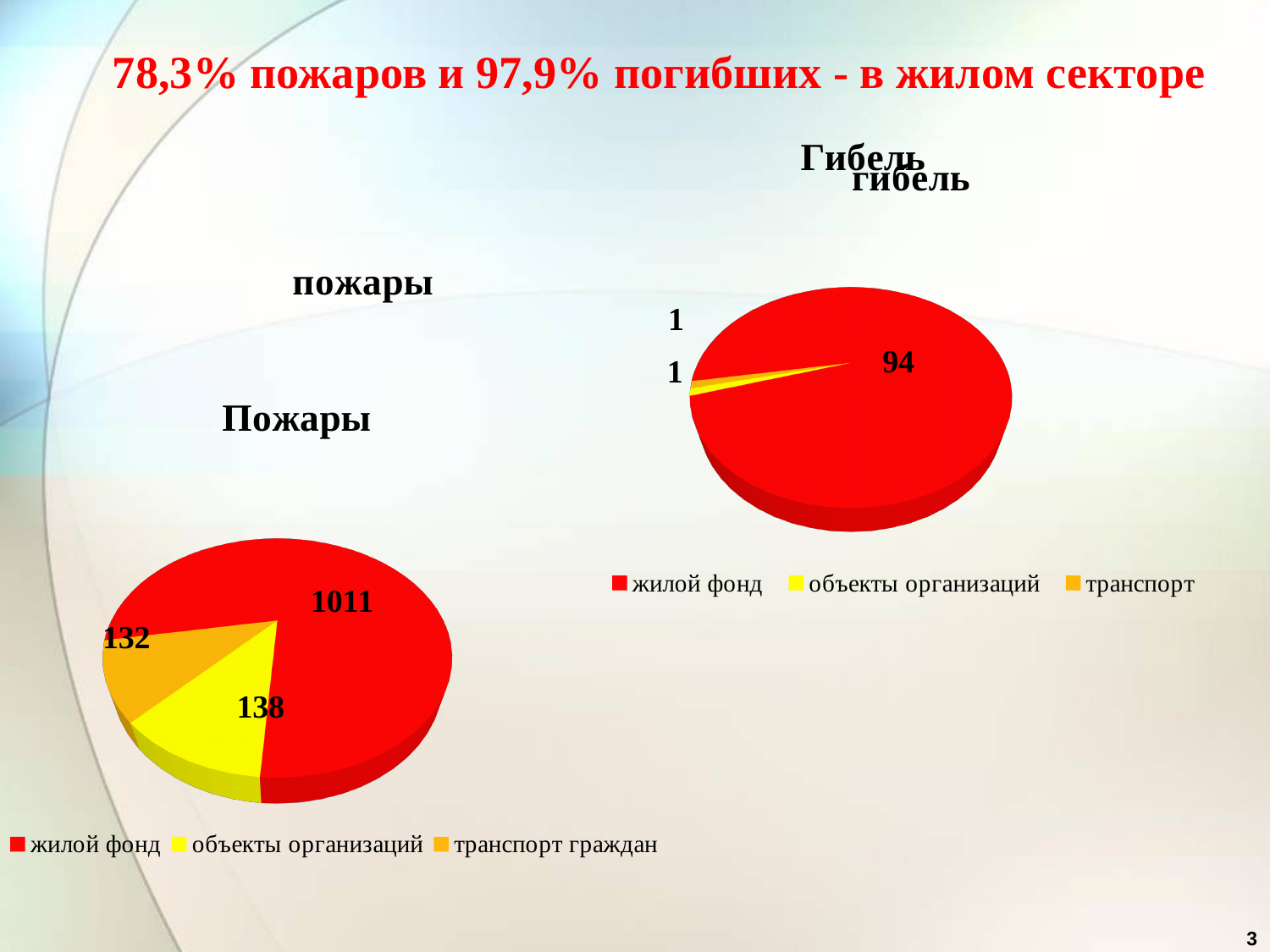
In the Пожары pie chart, what is the total of all slices? 1281 How many categories does the legend of the Гибель chart list? 3 In the Пожары pie chart, which category has the largest slice? жилой фонд In the Пожары pie chart, what is the value for жилой фонд? 1011 In the Гибель pie chart, which category has the largest slice? жилой фонд In the Пожары pie chart, what is the difference between жилой фонд and объекты организаций? 873 What type of chart is the Пожары chart? pie chart In the Пожары pie chart, what is the value for транспорт граждан? 132 In the Пожары pie chart, what is the value for объекты организаций? 138 In the Гибель pie chart, what is the value for транспорт? 1 In the Гибель pie chart, what is the total of all slices? 96 In the Гибель pie chart, what is the value for жилой фонд? 94